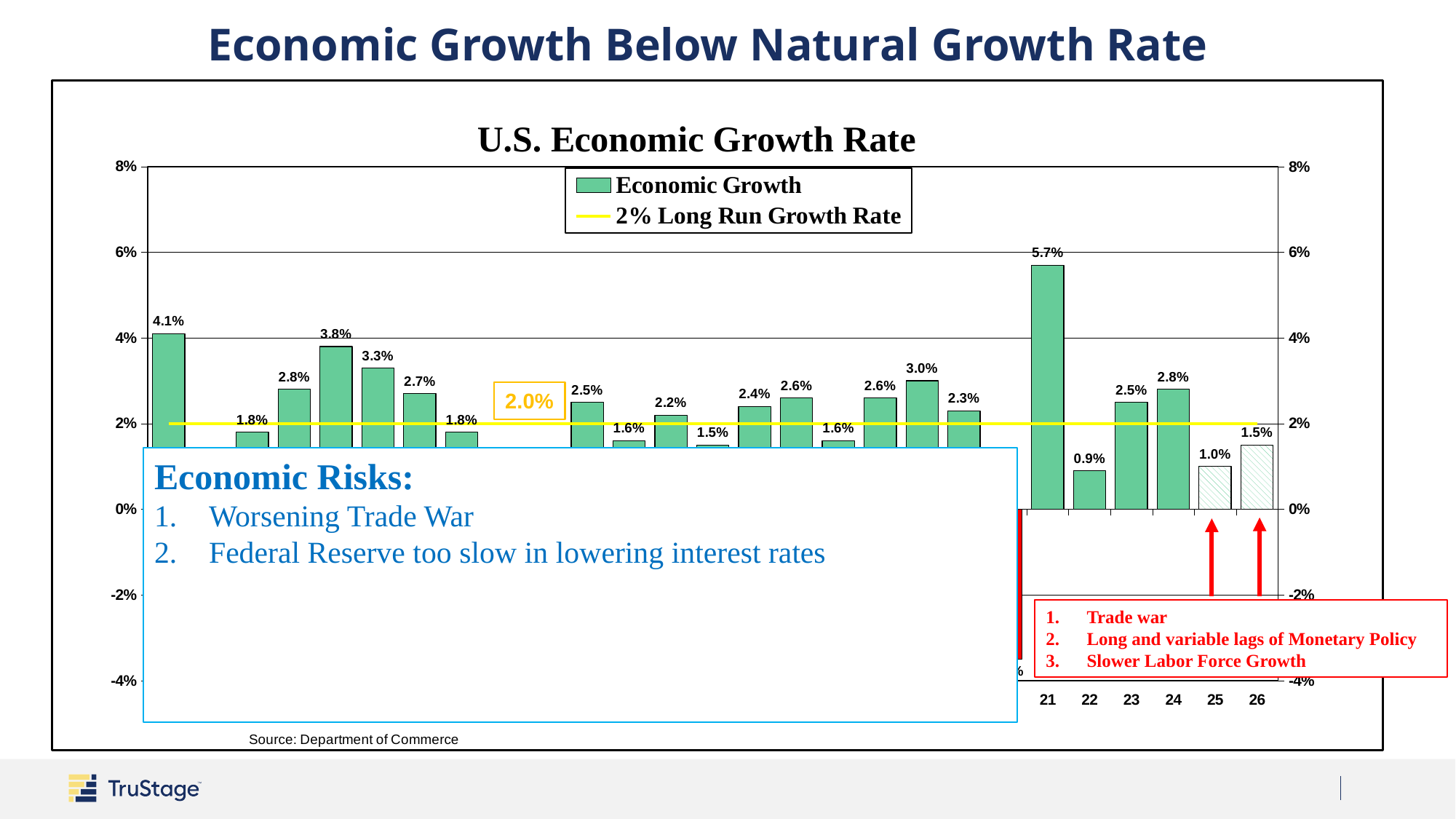
What is the economic growth rate for year 22? 0.9% How many series does the legend list? 2 What kind of chart is used to show Economic Growth? bar chart What is the difference between the economic growth rate in year 24 and year 25? 1.8% Which is larger, the economic growth rate in year 23 or year 25? year 23 What value does the yellow line in the chart represent? 2% Long Run Growth Rate What is the economic growth rate for year 21? 5.7% What is the economic growth rate for year 26? 1.5% What is the economic growth rate for year 24? 2.8% Which year from 21 to 26 has the lowest economic growth rate? 22 What is the title of the chart? U.S. Economic Growth Rate Which year from 21 to 26 has the highest economic growth rate? 21